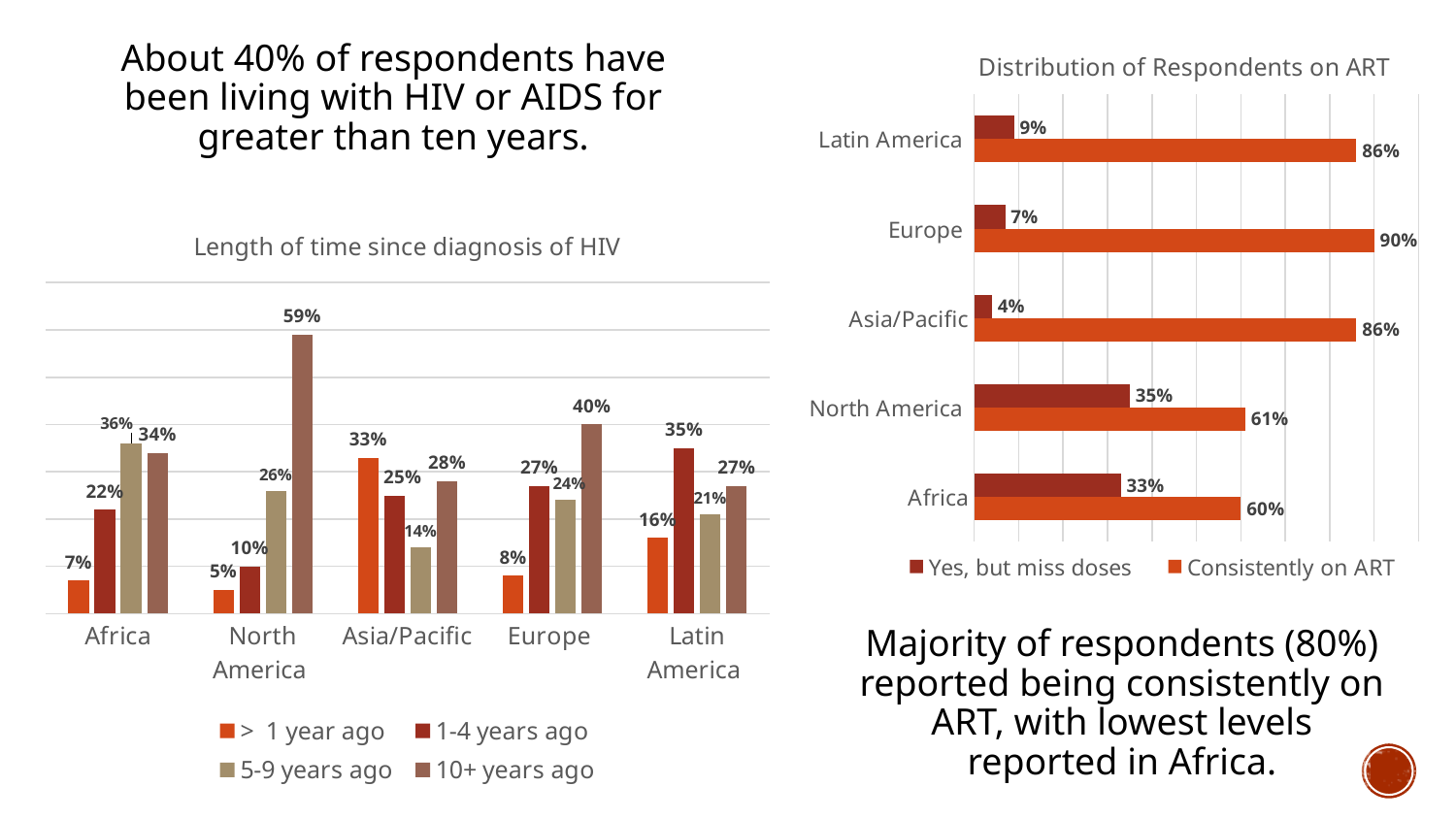
In the 'Length of time since diagnosis of HIV' chart, what is the value for '10+ years ago' in North America? 59% In the 'Length of time since diagnosis of HIV' chart, what is the difference between the '1-4 years ago' values for Latin America and Africa? 13% In the 'Distribution of Respondents on ART' chart, what is the 'Consistently on ART' value for Europe? 90% What kind of chart is the 'Distribution of Respondents on ART' chart? Bar chart In the 'Distribution of Respondents on ART' chart, which region has the lowest 'Consistently on ART' value? Africa In the 'Length of time since diagnosis of HIV' chart, which region has the highest value for '10+ years ago'? North America In the 'Length of time since diagnosis of HIV' chart, which region has the lowest value for '> 1 year ago'? North America In the 'Distribution of Respondents on ART' chart, which region has the highest 'Yes, but miss doses' value? North America How many series does the legend of the 'Length of time since diagnosis of HIV' chart list? 4 How many regions are shown in the 'Distribution of Respondents on ART' chart? 5 In the 'Distribution of Respondents on ART' chart, is the 'Yes, but miss doses' value larger for Asia/Pacific or Latin America? Latin America In the 'Length of time since diagnosis of HIV' chart, what is the value for '> 1 year ago' in Asia/Pacific? 33%